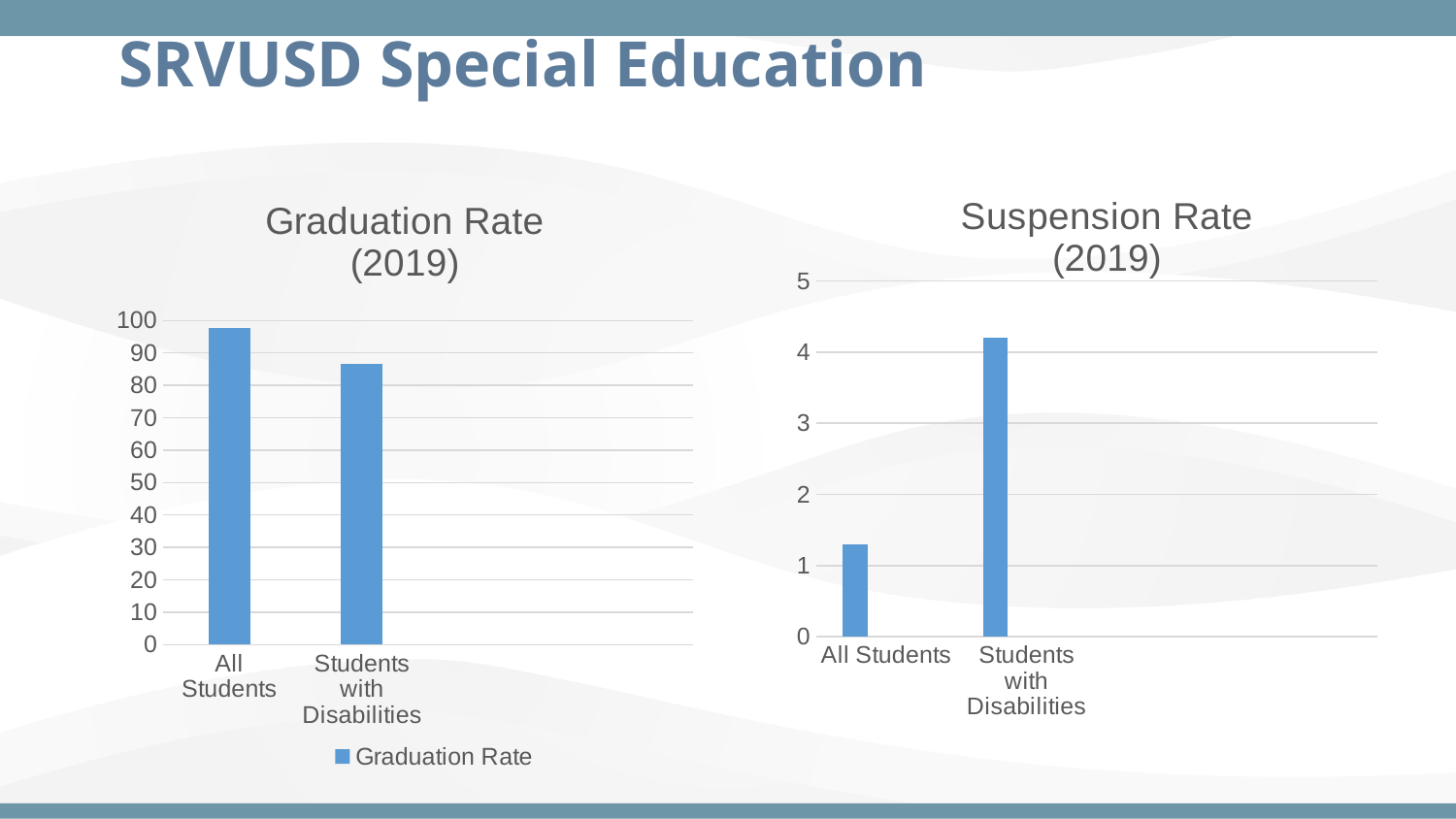
In the Graduation Rate (2019) chart, which is larger: the value for All Students or the value for Students with Disabilities? All Students In the Suspension Rate (2019) chart, which category has the lowest value? All Students How many categories are shown in the Suspension Rate (2019) chart? 2 In the Suspension Rate (2019) chart, is the value for All Students greater or less than 2? less In the Suspension Rate (2019) chart, which category has the highest value? Students with Disabilities What kind of chart is the Suspension Rate (2019) chart? bar chart In the Suspension Rate (2019) chart, is the value for Students with Disabilities greater or less than 4? greater In the Graduation Rate (2019) chart, which category has the highest value? All Students What kind of chart is the Graduation Rate (2019) chart? bar chart In the Graduation Rate (2019) chart, is the value for Students with Disabilities greater or less than 90? less How many series does the legend of the Graduation Rate (2019) chart list? 1